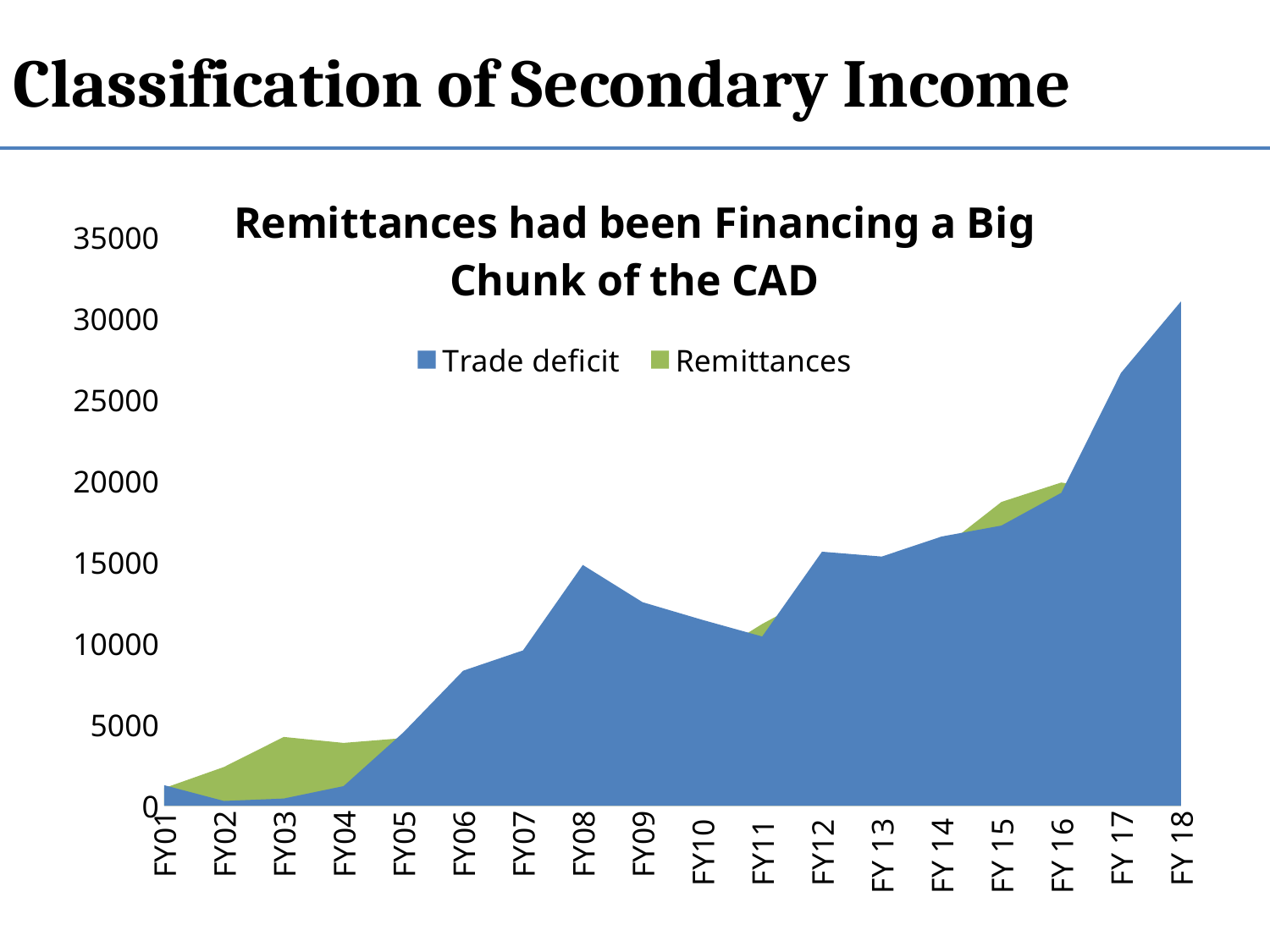
Is the Trade deficit for FY 18 greater or less than 25000? greater Is the Trade deficit for FY08 greater or less than 10000? greater Does the Trade deficit rise or fall from FY 13 to FY 18? Rise Is the Trade deficit for FY 17 greater or less than 25000? greater How many series does the legend list? 2 Which is larger, the Trade deficit in FY08 or in FY09? FY08 What is the title of the chart? Remittances had been Financing a Big Chunk of the CAD Which is larger, the Trade deficit in FY11 or in FY12? FY12 In which fiscal year is the Trade deficit highest? FY 18 What kind of chart is shown on the slide? Area chart How many fiscal years are shown on the x axis? 18